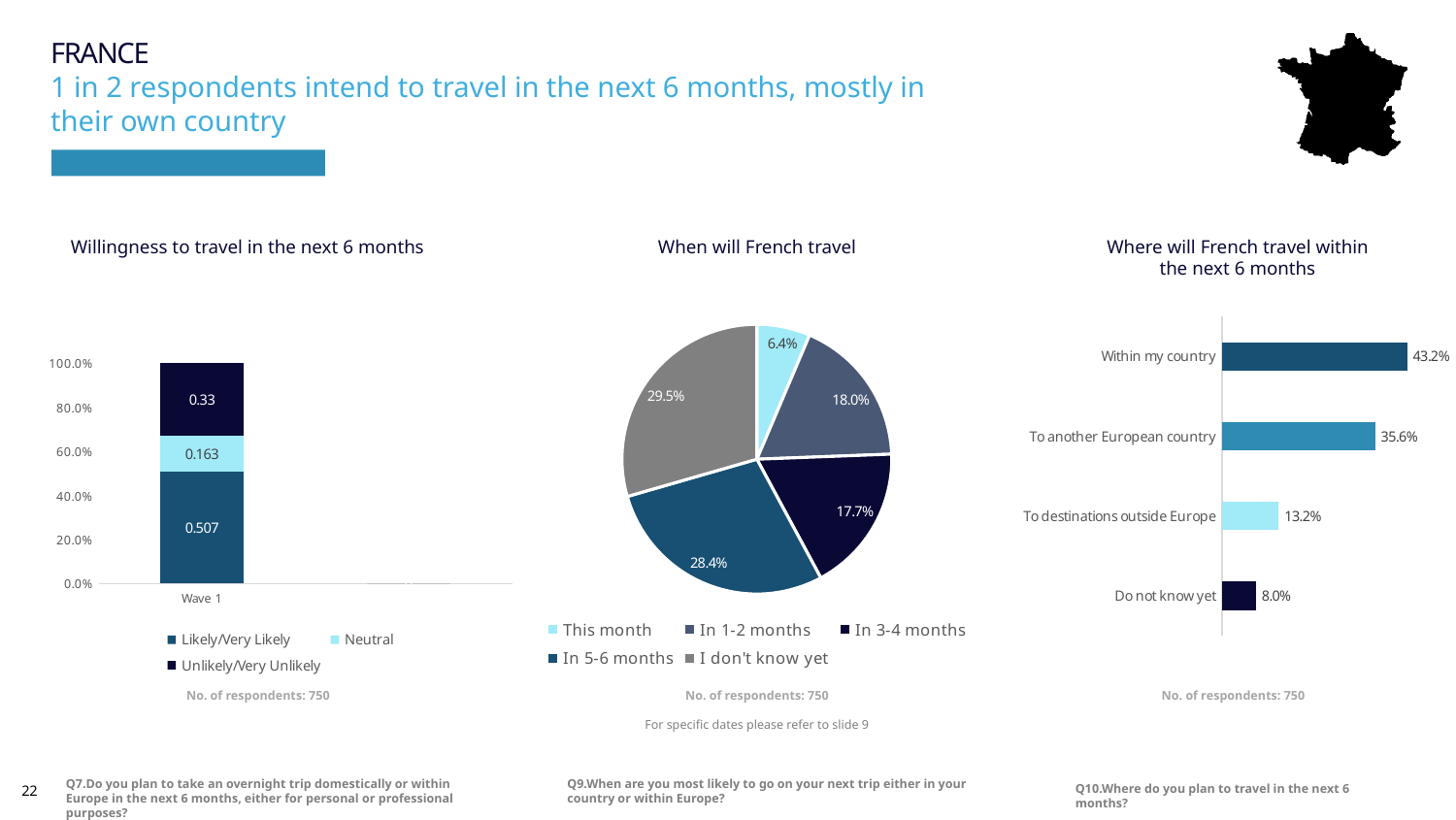
In the 'Where will French travel within the next 6 months' chart, which category has the lowest value? Do not know yet In the 'Willingness to travel in the next 6 months' chart, what is the value for 'Neutral' in Wave 1? 0.163 In the 'Willingness to travel in the next 6 months' chart, what is the value for 'Likely/Very Likely' in Wave 1? 0.507 In the 'When will French travel' pie chart, which slice is the largest? I don't know yet In the 'Where will French travel within the next 6 months' chart, what is the difference between 'Within my country' and 'To another European country'? 7.6% In the 'Willingness to travel in the next 6 months' chart, what is the total of the Wave 1 stacked bar? 1.0 In the 'When will French travel' pie chart, what share is 'In 5-6 months'? 28.4% In the 'Where will French travel within the next 6 months' chart, what is the value for 'Within my country'? 43.2% How many entries does the legend of the 'When will French travel' pie chart list? 5 What kind of chart is 'Where will French travel within the next 6 months'? Bar chart In the 'Where will French travel within the next 6 months' chart, how many categories are shown? 4 In the 'When will French travel' pie chart, which is larger: 'In 1-2 months' or 'In 3-4 months'? In 1-2 months